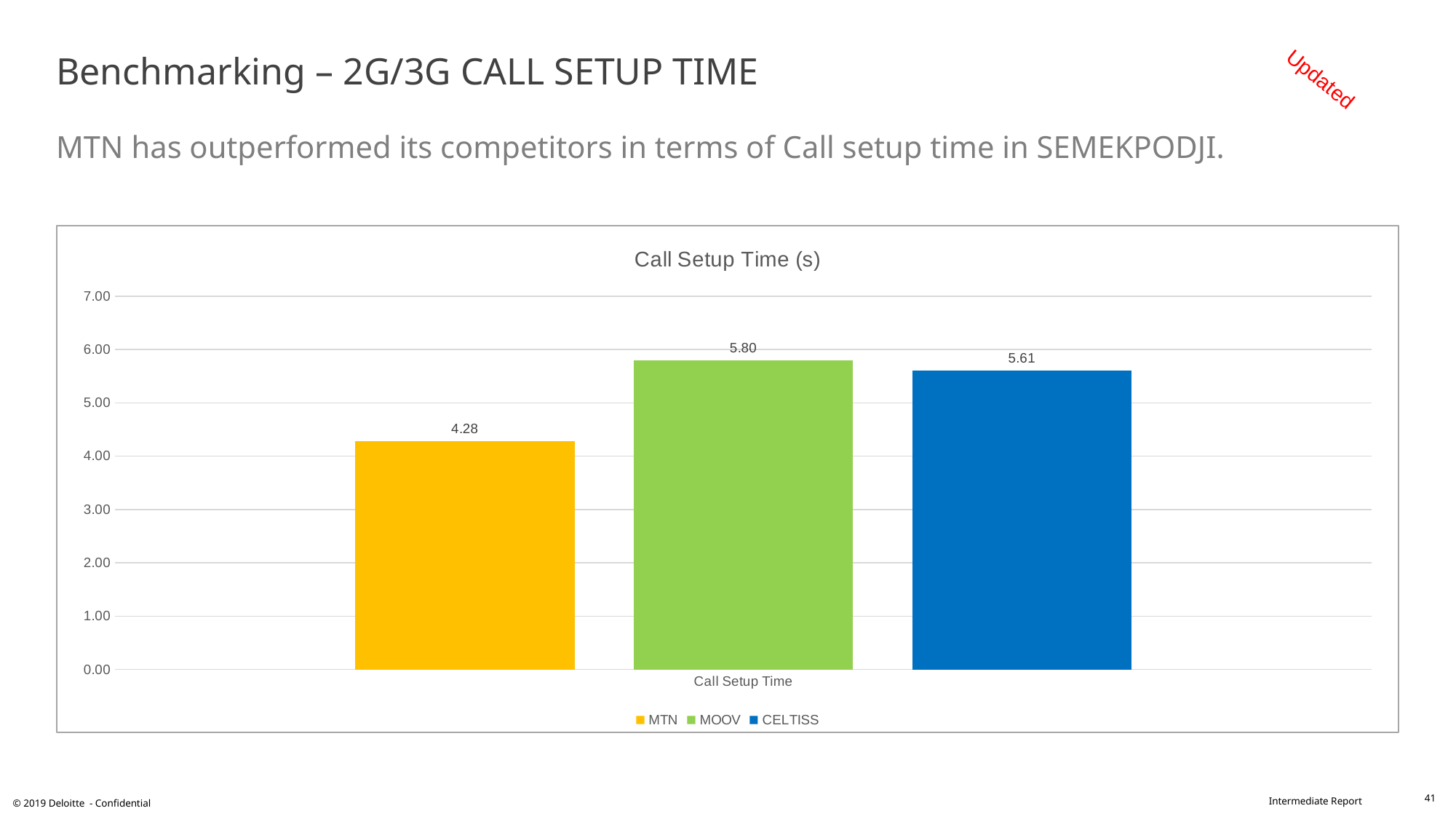
What is the difference in call setup time between CELTISS and MTN? 1.33 How many series does the legend list? 3 What is the call setup time for CELTISS? 5.61 Which operator has the highest call setup time? MOOV What is the difference in call setup time between MOOV and MTN? 1.52 Which operator has the lowest call setup time? MTN Which has a larger call setup time, MOOV or CELTISS? MOOV What kind of chart is shown on the slide? bar chart What is the call setup time for MOOV? 5.80 What is the title of the chart? Call Setup Time (s) What is the call setup time for MTN? 4.28 Is the call setup time for MTN greater or less than 5.00? less